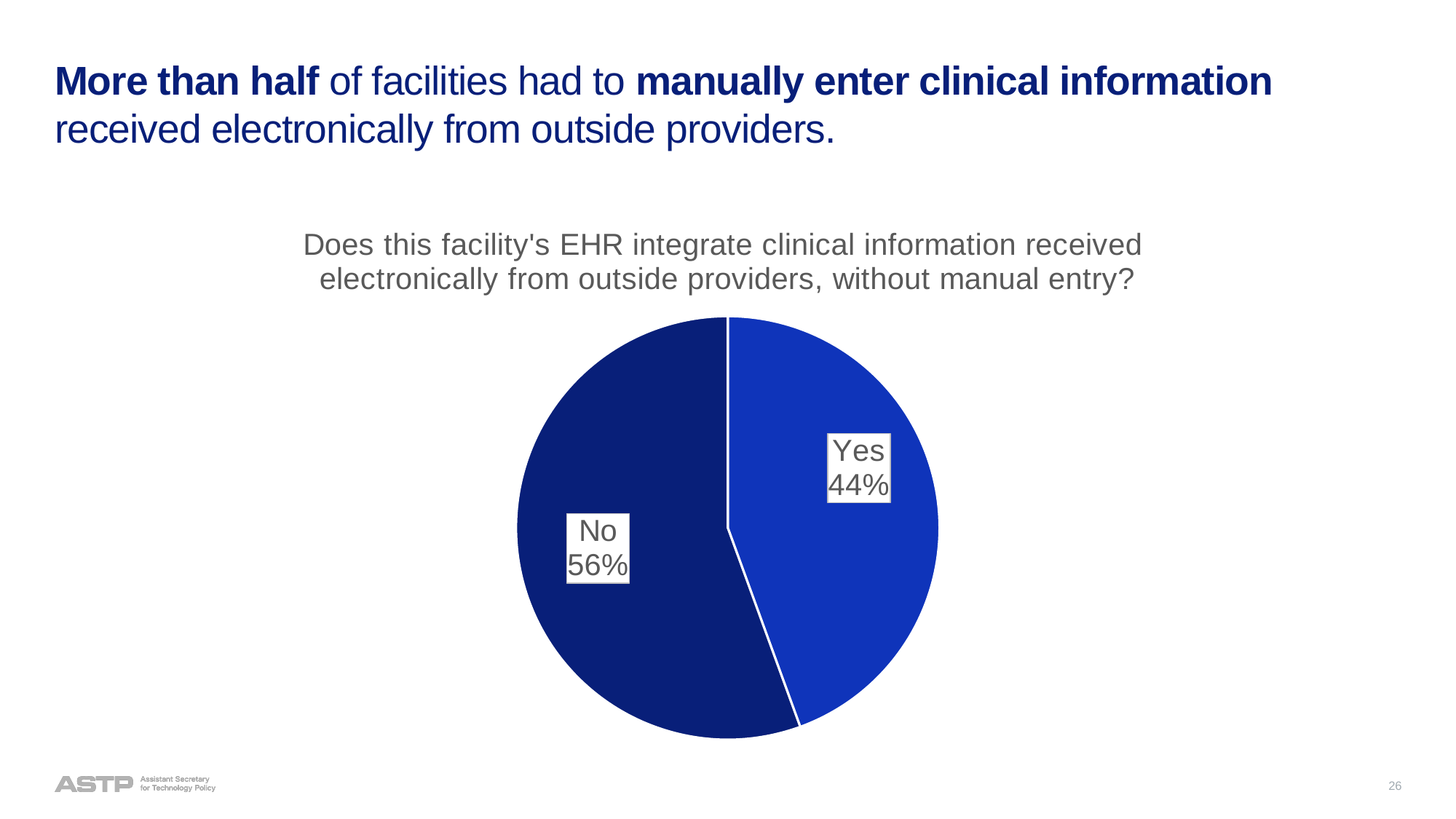
What is the title of the chart? Does this facility's EHR integrate clinical information received electronically from outside providers, without manual entry? What kind of chart is shown on the slide? Pie chart Which is larger, the "Yes" slice or the "No" slice? No Which slice of the pie chart is the smallest? Yes What is the difference in percentage points between the "No" and "Yes" slices? 12 What share of the pie does the "No" slice represent? 56% Which slice of the pie chart is the largest? No What percentage of facilities answered "Yes" in the pie chart? 44% What percentage of facilities answered "No" in the pie chart? 56% How many slices does the pie chart have? 2 Which slice is shown in the darker blue colour? No